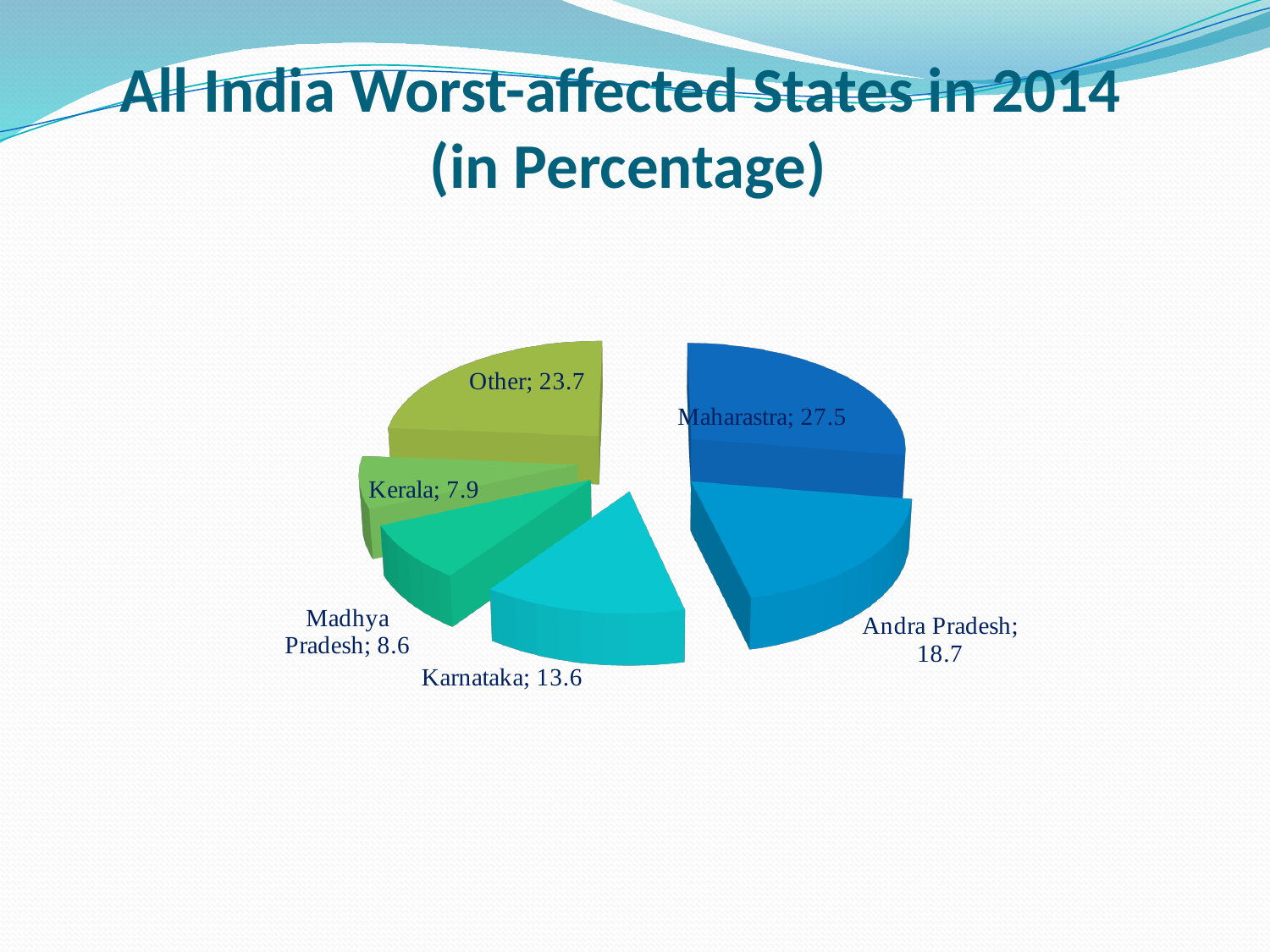
What share of the pie does the Other slice represent? 23.7 What is the title of the slide containing the chart? All India Worst-affected States in 2014 (in Percentage) Which category has the largest slice of the pie? Maharastra What is the difference between the values for Maharastra and Andra Pradesh? 8.8 What is the value for Andra Pradesh? 18.7 What type of chart is shown on the slide? pie chart What is the value for Kerala? 7.9 What is the value for Karnataka? 13.6 Which is larger, the value for Madhya Pradesh or the value for Kerala? Madhya Pradesh What is the value for Maharastra? 27.5 Which category has the smallest slice of the pie? Kerala How many slices does the pie chart have? 6